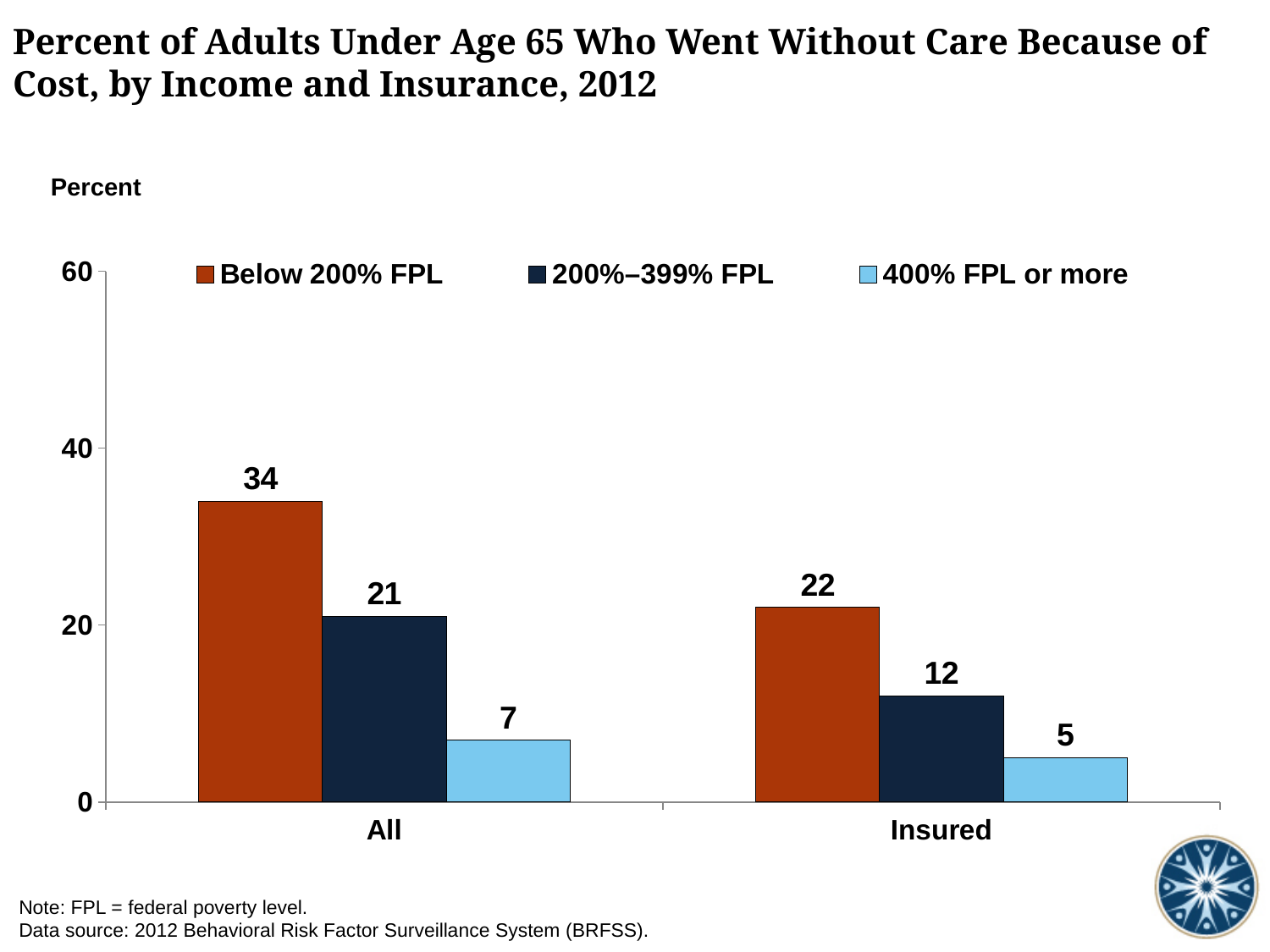
What is the value for 200%–399% FPL in the Insured category? 12 Which income group has the lowest value in the Insured category? 400% FPL or more Which income group has the highest value in the All category? Below 200% FPL What is the value for Below 200% FPL in the All category? 34 How many series does the legend list? 3 How many categories are shown on the x axis? 2 What is the difference between Below 200% FPL and 400% FPL or more in the All category? 27 What is the value for 400% FPL or more in the Insured category? 5 Which is larger: 200%–399% FPL for All or Below 200% FPL for Insured? Insured, Below 200% FPL What kind of chart is shown on the slide? Bar chart What is the difference between the Below 200% FPL values for All and Insured? 12 Is the value for Below 200% FPL in the All category greater or less than 40? less